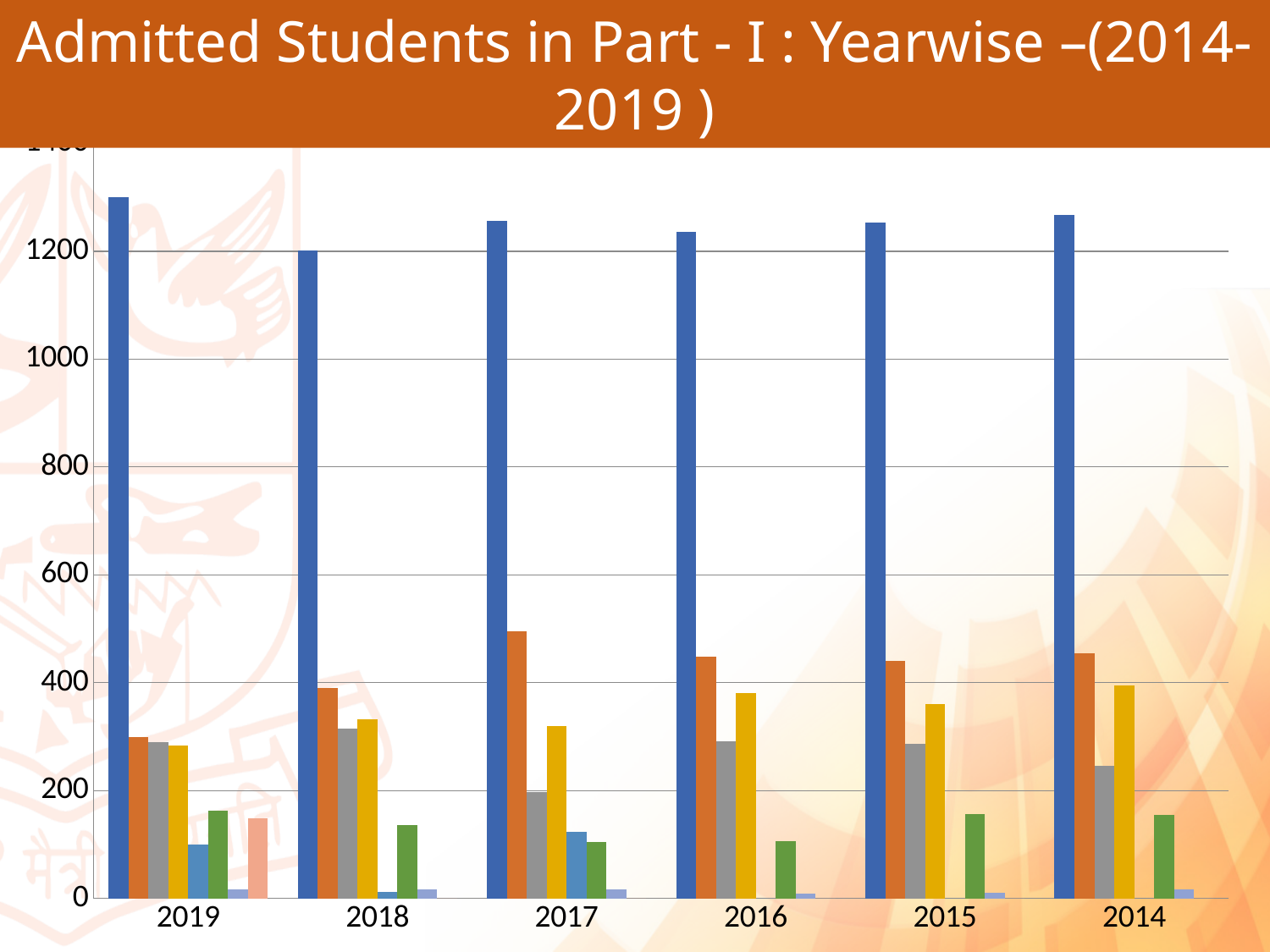
Which is larger, the green bar for 2019 or the green bar for 2016? 2019 Is the orange bar for 2017 greater or less than 400? greater What kind of chart is shown on the slide? bar chart Is the dark blue bar for 2019 greater or less than 1200? greater What is the title of the chart on the slide? Admitted Students in Part - I : Yearwise –(2014-2019 ) Which year has the tallest orange bar? 2017 Which is larger, the orange bar for 2017 or the orange bar for 2018? 2017 How many years are shown along the x axis of the chart? 6 Which year has the shortest dark blue bar? 2018 Is the green bar for 2018 greater or less than 200? less Which year has the tallest dark blue bar? 2019